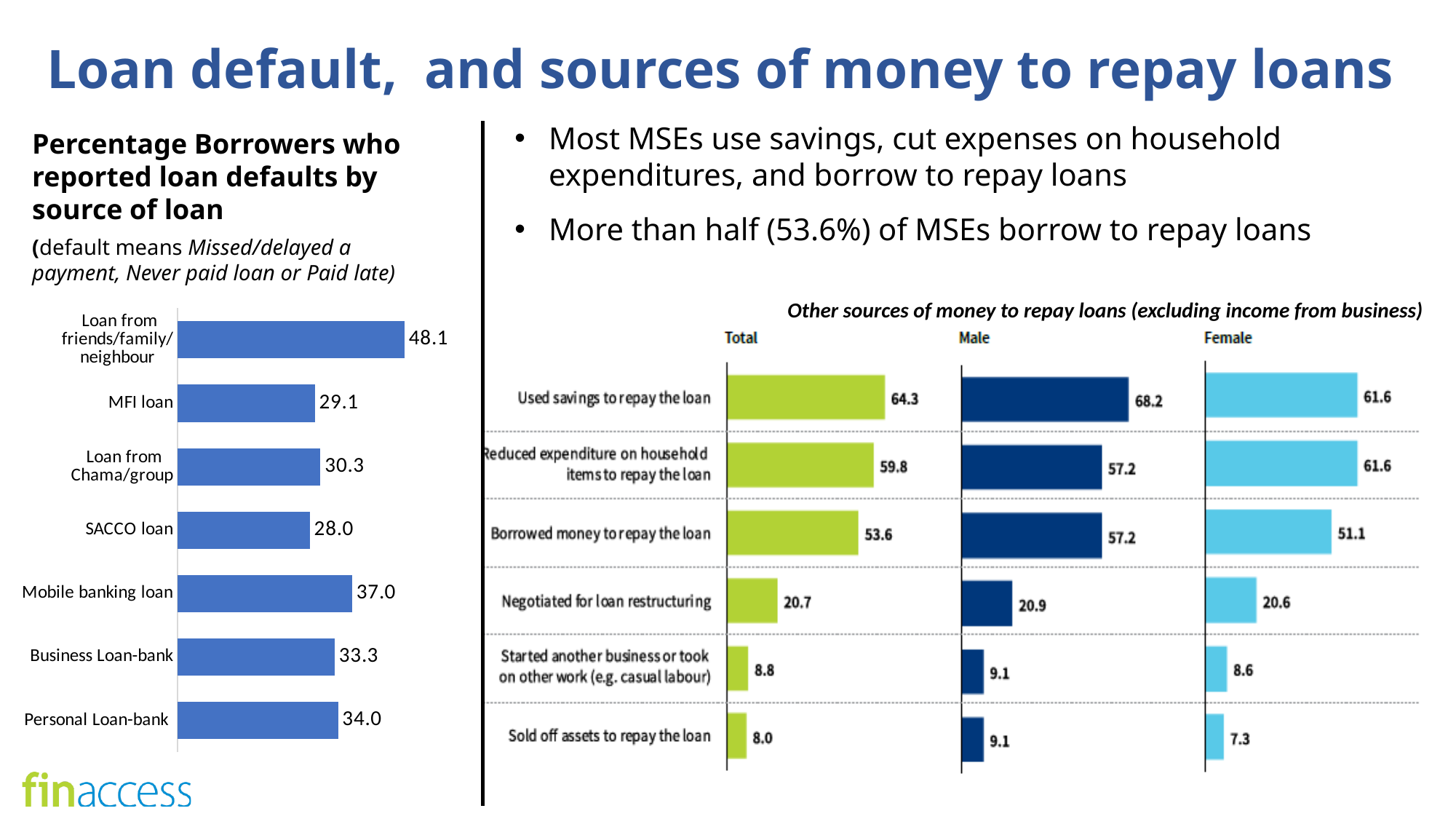
In the left chart on loan defaults by source of loan, what percentage of borrowers with a loan from friends/family/neighbour reported a default? 48.1 In the right chart on other sources of money to repay loans, what is the Male value for 'Used savings to repay the loan'? 68.2 In the right chart on other sources of money to repay loans, what is the difference between the Male and Female values for 'Used savings to repay the loan'? 6.6 In the left chart on loan defaults by source of loan, what is the difference between the values for Mobile banking loan and MFI loan? 7.9 In the left chart on loan defaults by source of loan, how many sources of loan are shown? 7 In the right chart on other sources of money to repay loans, what is the Female value for 'Borrowed money to repay the loan'? 51.1 In the left chart on loan defaults by source of loan, which source of loan has the highest percentage of borrowers reporting defaults? Loan from friends/family/neighbour In the right chart on other sources of money to repay loans, is the Total value for 'Used savings to repay the loan' larger or the Total value for 'Borrowed money to repay the loan'? Used savings to repay the loan In the right chart on other sources of money to repay loans, which source has the lowest Total value? Sold off assets to repay the loan In the left chart on loan defaults by source of loan, which source of loan has the lowest percentage of borrowers reporting defaults? SACCO loan What kind of chart is the left chart on loan defaults by source of loan? Bar chart In the right chart on other sources of money to repay loans, how many series (column groups) are shown? 3